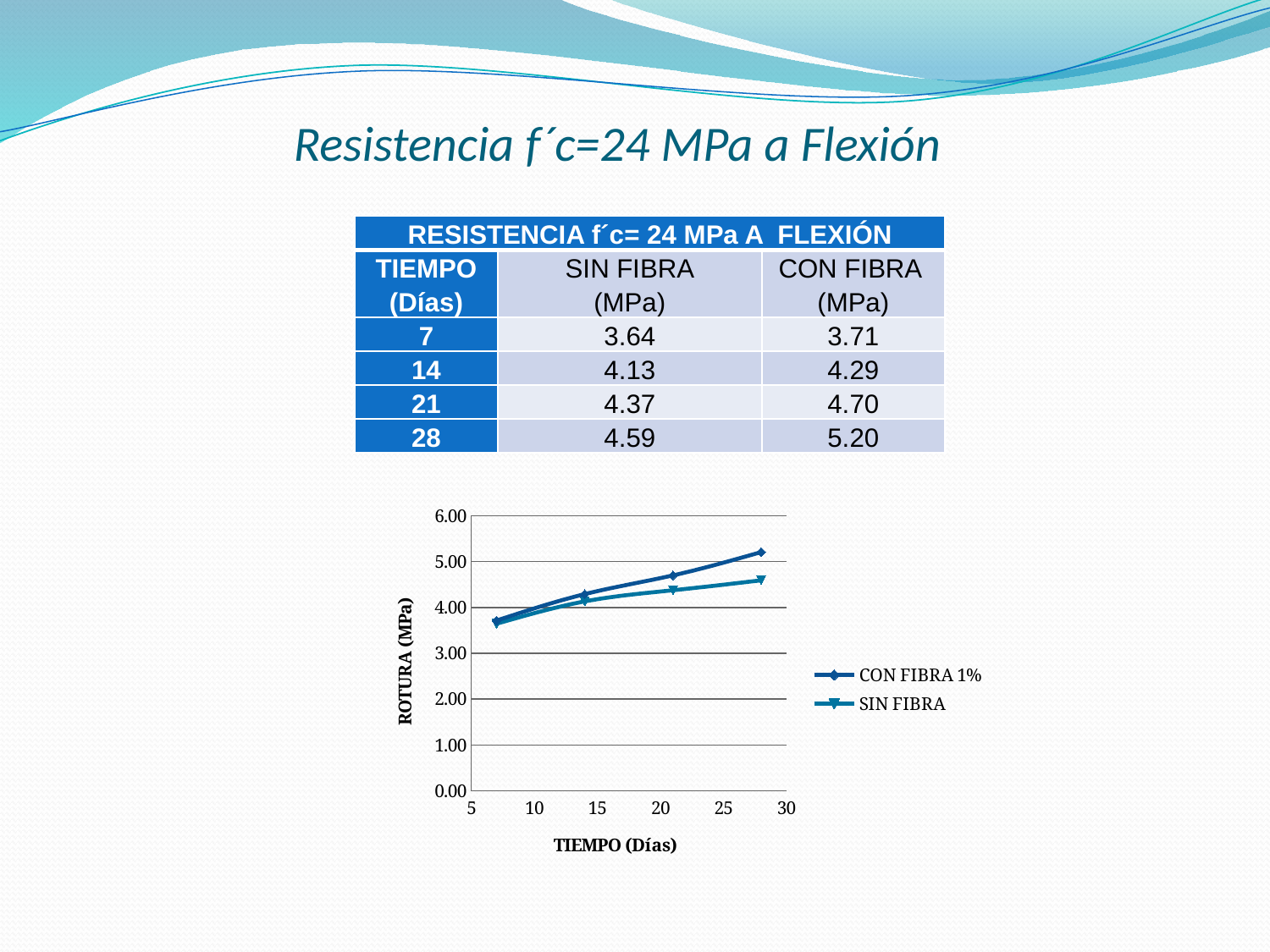
Do the values of the CON FIBRA 1% series rise or fall as time (days) increases? rise How many series does the chart legend list? 2 What is the label of the chart's vertical axis? ROTURA (MPa) According to the table, what is the CON FIBRA value at 21 days? 4.70 According to the table, what is the SIN FIBRA value at 28 days? 4.59 In the chart, is the value for SIN FIBRA at 7 days greater or less than 4.00? less In the chart, is the value for CON FIBRA 1% at 28 days greater or less than 5.00? greater What kind of chart is shown on the slide? line chart How many data points does each line in the chart have? 4 Using the table values, what is the difference between CON FIBRA and SIN FIBRA at 28 days? 0.61 What are the two series named in the chart legend? CON FIBRA 1% and SIN FIBRA At 28 days, which series has the higher value, CON FIBRA 1% or SIN FIBRA? CON FIBRA 1%